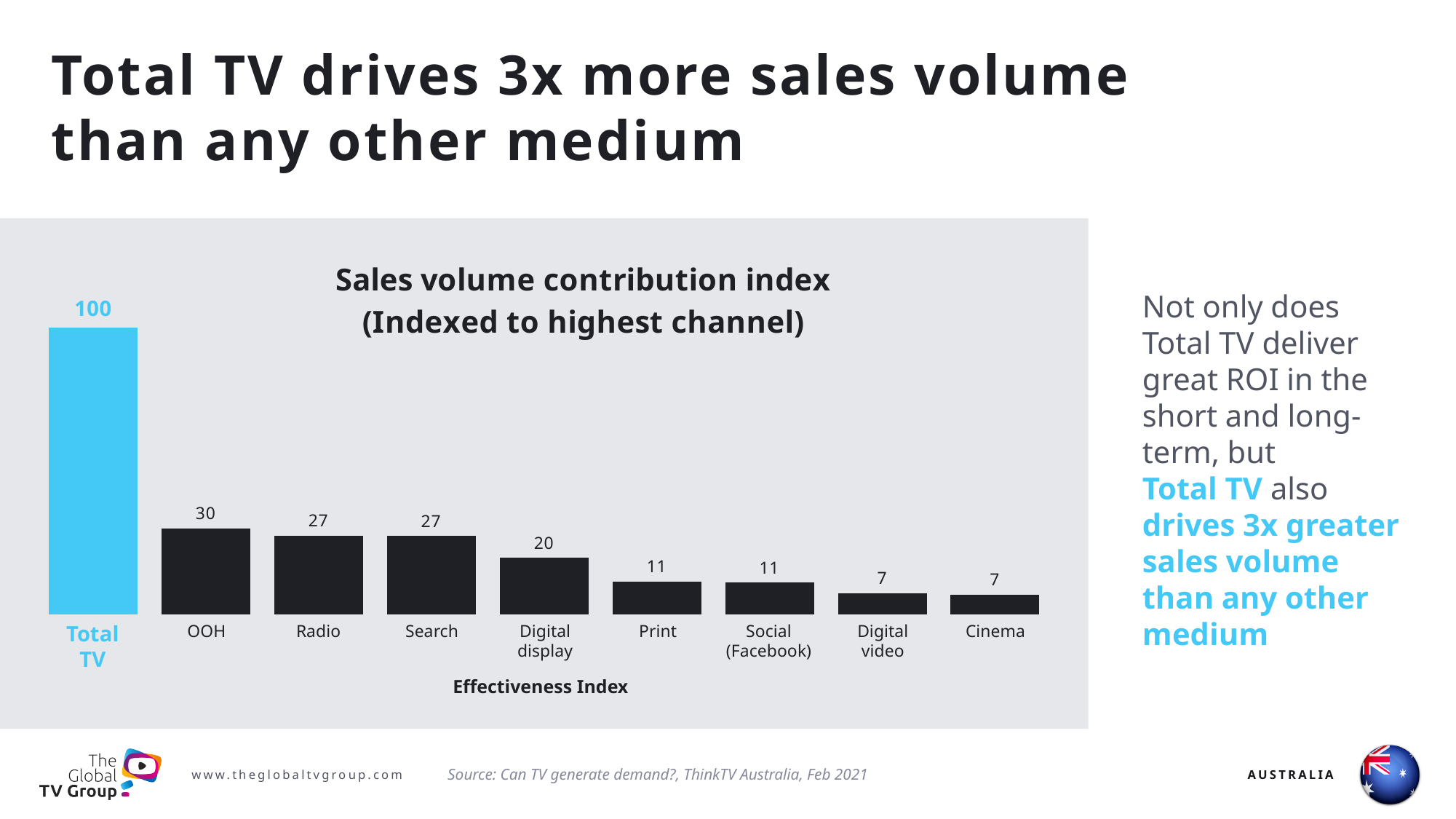
What is the index value for Social (Facebook)? 11 How many channels are shown in the chart? 9 What type of chart is shown on the slide? Bar chart Which has a higher index value, Digital display or Print? Digital display What is the index value for OOH? 30 What is the difference between the index values for Total TV and OOH? 70 Which has a higher index value, OOH or Search? OOH What is the index value for Digital display? 20 What is the title of the chart? Sales volume contribution index (Indexed to highest channel) What is the sales volume contribution index value for Total TV? 100 What is the difference between the index values for Radio and Print? 16 Which channel has the highest sales volume contribution index? Total TV